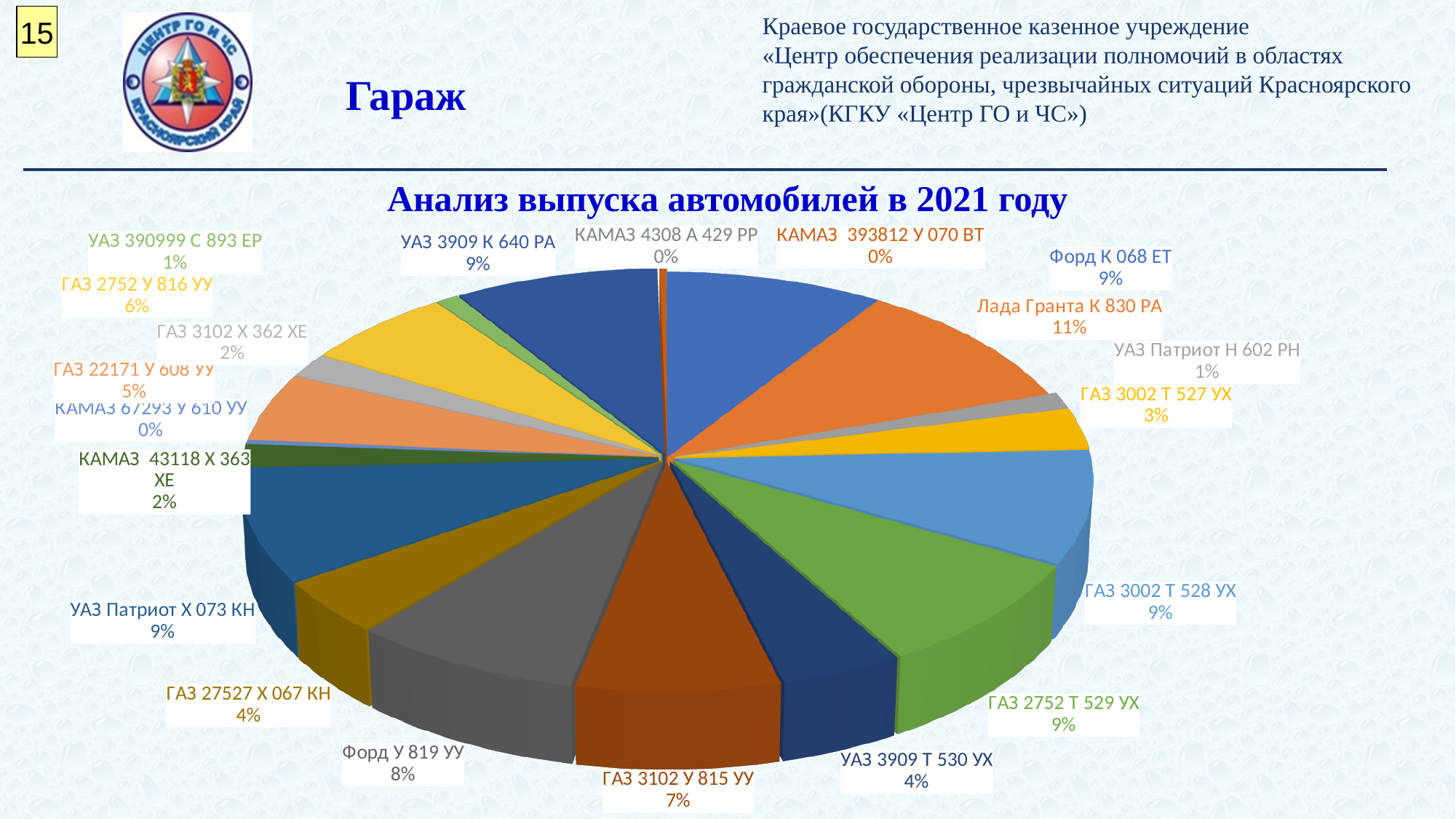
What is the title of the chart? Анализ выпуска автомобилей в 2021 году What kind of chart is shown on the slide? pie chart What is the difference in percentage points between Лада Гранта К 830 РА and Форд К 068 ЕТ? 2 What share of the pie does Лада Гранта К 830 РА have? 11% Which has the larger share: УАЗ Патриот Х 073 КН or ГАЗ 27527 Х 067 КН? УАЗ Патриот Х 073 КН What share of the pie does Форд У 819 УУ have? 8% What share of the pie does ГАЗ 3002 Т 527 УХ have? 3% Which vehicle has the largest share of the pie? Лада Гранта К 830 РА How many vehicles (slices) are shown in the pie chart? 20